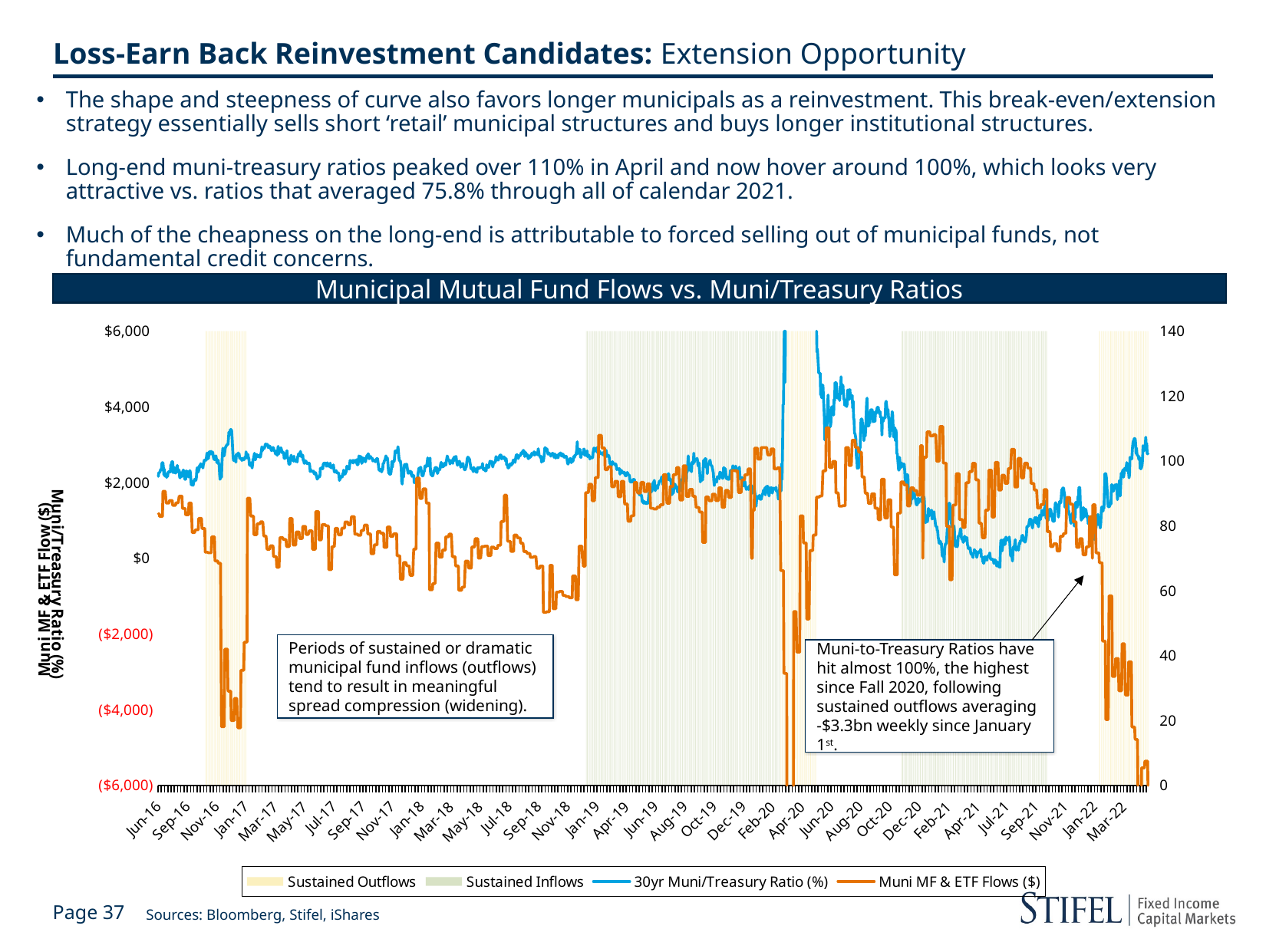
What is the lowest value shown on the left-hand axis (Muni MF & ETF Flow)? ($6,000) Is the 30yr Muni/Treasury Ratio (%) around Jul-21 greater or less than 100? less Is the 30yr Muni/Treasury Ratio (%) around Apr-20 greater or less than 120? greater Does the Muni MF & ETF Flows ($) line rise or fall between Jan-22 and Mar-22? Fall Does the 30yr Muni/Treasury Ratio (%) line rise or fall between Jan-22 and Mar-22? Rise Which colour is used for the 30yr Muni/Treasury Ratio (%) line? Blue What is the title of the chart? Municipal Mutual Fund Flows vs. Muni/Treasury Ratios What is the highest value shown on the right-hand axis (Muni/Treasury Ratio)? 140 What kind of chart is shown on the slide? Line chart How many entries does the chart's legend list? 4 Is the Muni MF & ETF Flows ($) value around Mar-22 greater or less than $0? less